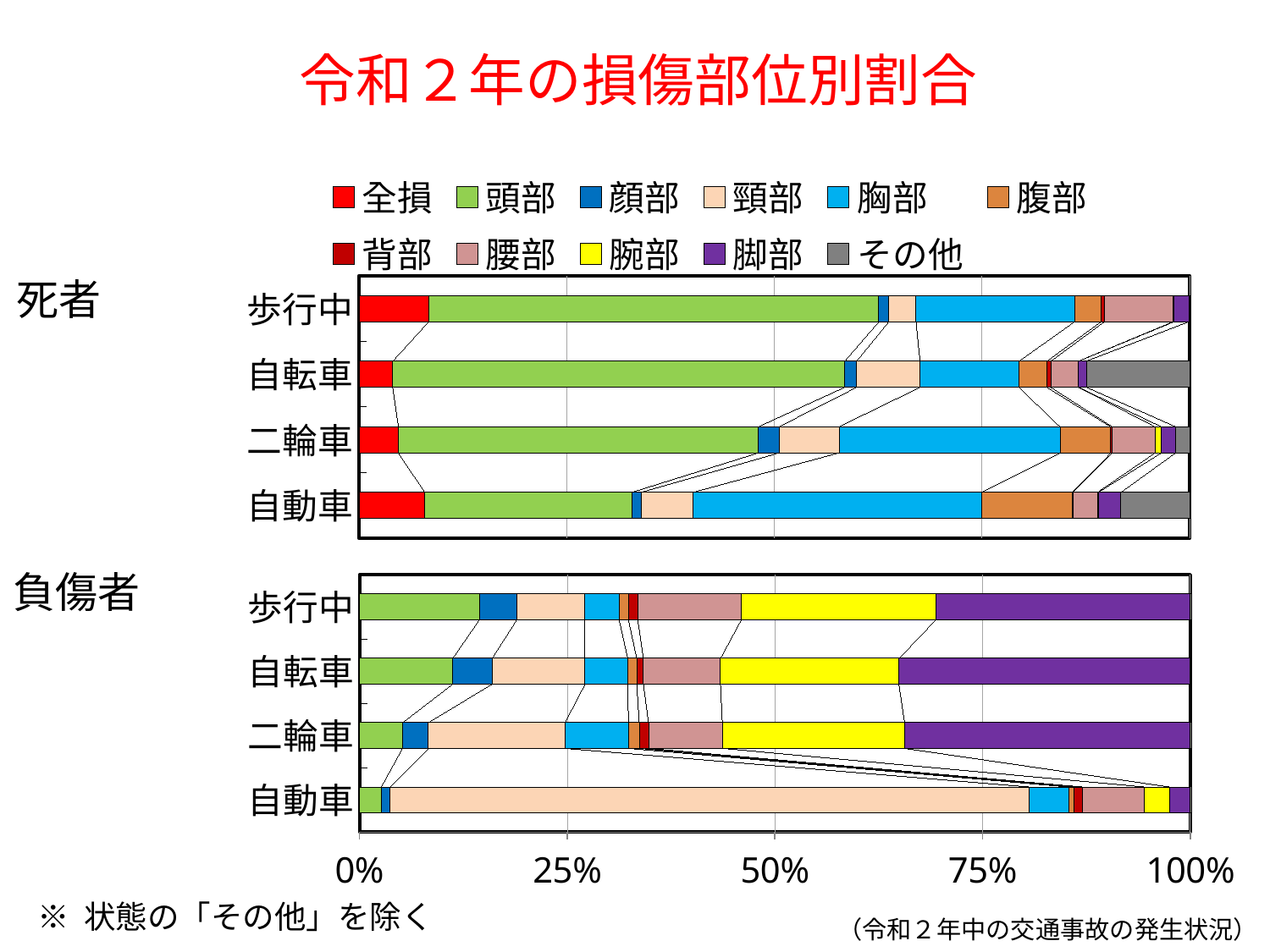
In the 死者 chart, how many categories are plotted? 4 What is the title of the slide's chart? 令和２年の損傷部位別割合 In the 死者 chart, is the 頭部 share for 歩行中 greater or less than 50%? greater In the 負傷者 chart, which category has the smallest 頭部 share? 自動車 What type of chart is used on this slide? Stacked bar chart In the 死者 chart, which has the larger 頭部 share, 歩行中 or 自動車? 歩行中 In the 負傷者 chart, is the 頸部 share for 自動車 greater or less than 75%? greater How many series does the legend list? 11 In the 負傷者 chart, is the 脚部 share for 歩行中 greater or less than 25%? greater In the 負傷者 chart, how many categories are plotted? 4 In the 負傷者 chart, which category has the largest 頸部 share? 自動車